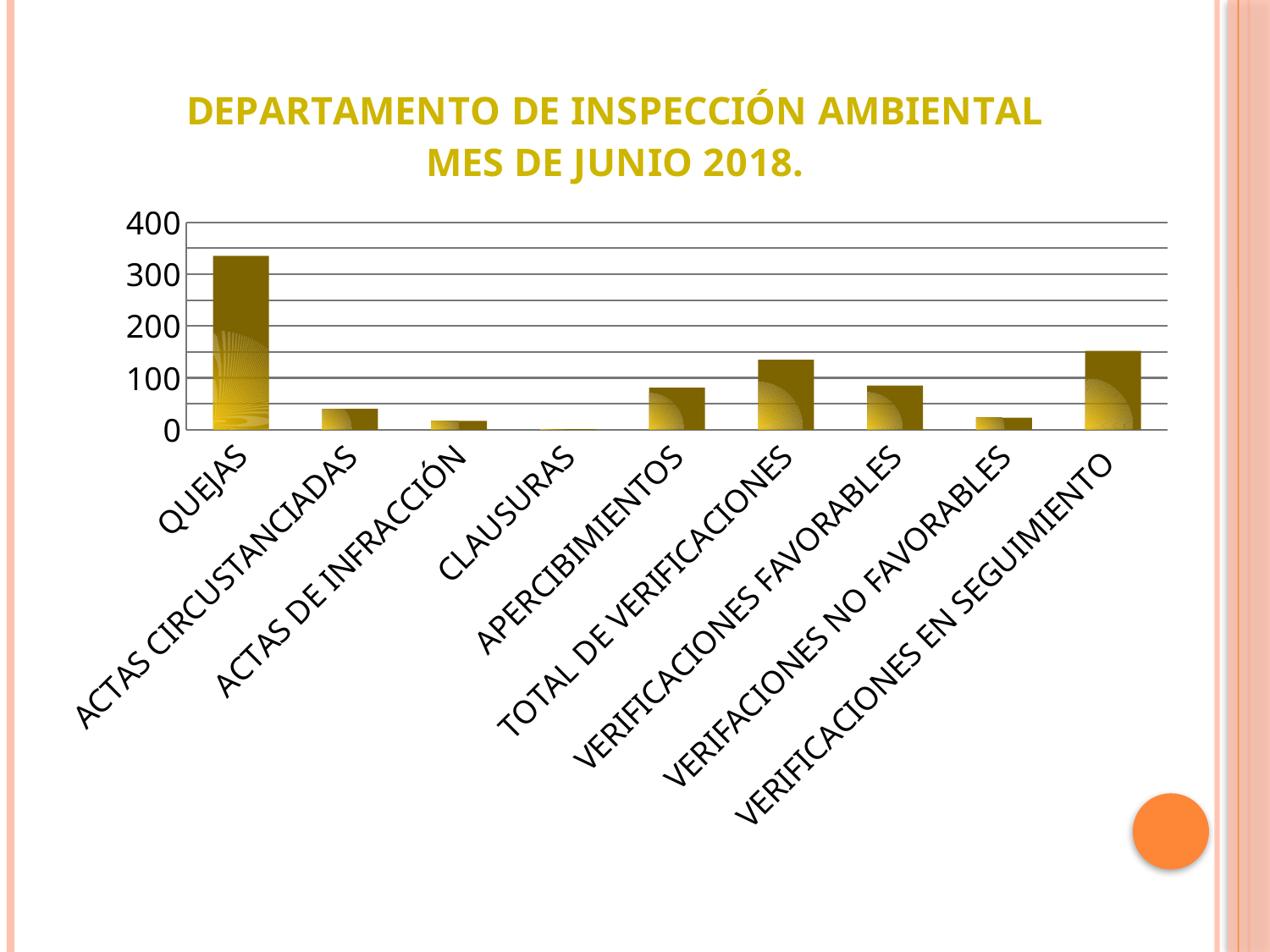
Is the value for QUEJAS greater or less than 300? greater Is the value for APERCIBIMIENTOS greater or less than 100? less Which category has the highest value in the chart? QUEJAS How many categories are shown on the x axis of the chart? 9 Which is larger, the value for QUEJAS or the value for VERIFICACIONES EN SEGUIMIENTO? QUEJAS What kind of chart is shown on the slide? Bar chart Is the value for VERIFICACIONES EN SEGUIMIENTO greater or less than 200? less What is the title of the chart on the slide? DEPARTAMENTO DE INSPECCIÓN AMBIENTAL MES DE JUNIO 2018. Which is larger, the value for APERCIBIMIENTOS or the value for ACTAS DE INFRACCIÓN? APERCIBIMIENTOS Which category has the lowest value in the chart? CLAUSURAS